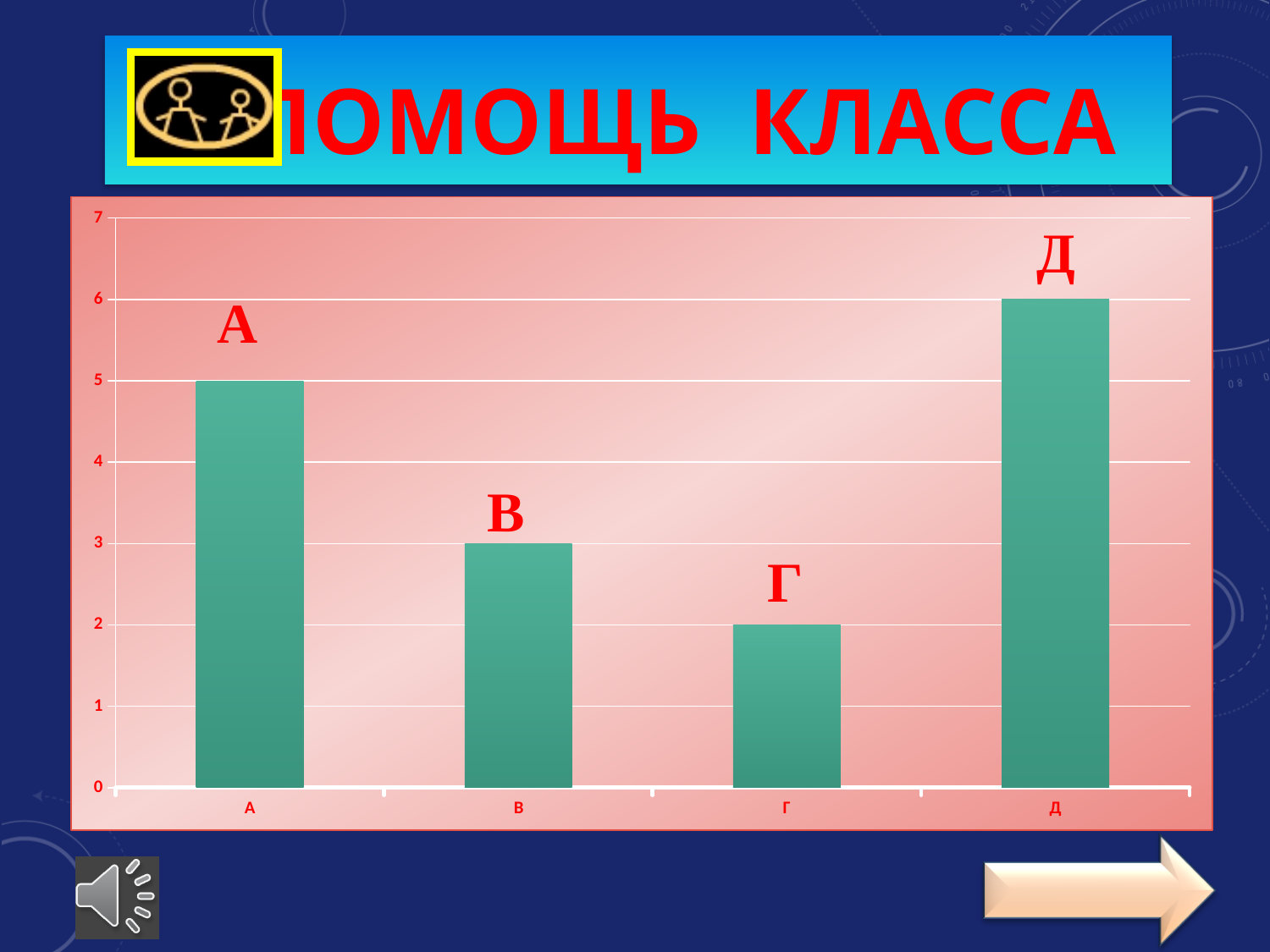
Is the value for Д greater or less than 4? greater What is the value for category Г? 2 Which is larger, the value for А or the value for В? А How many categories are shown on the x axis of the chart? 4 What is the value for category В? 3 What is the maximum value shown on the vertical axis? 7 What is the difference between the values for Д and Г? 4 What type of chart is shown on the slide? bar chart What is the value for category А? 5 What is the value for category Д? 6 Which category has the lowest value? Г Which category has the highest value? Д